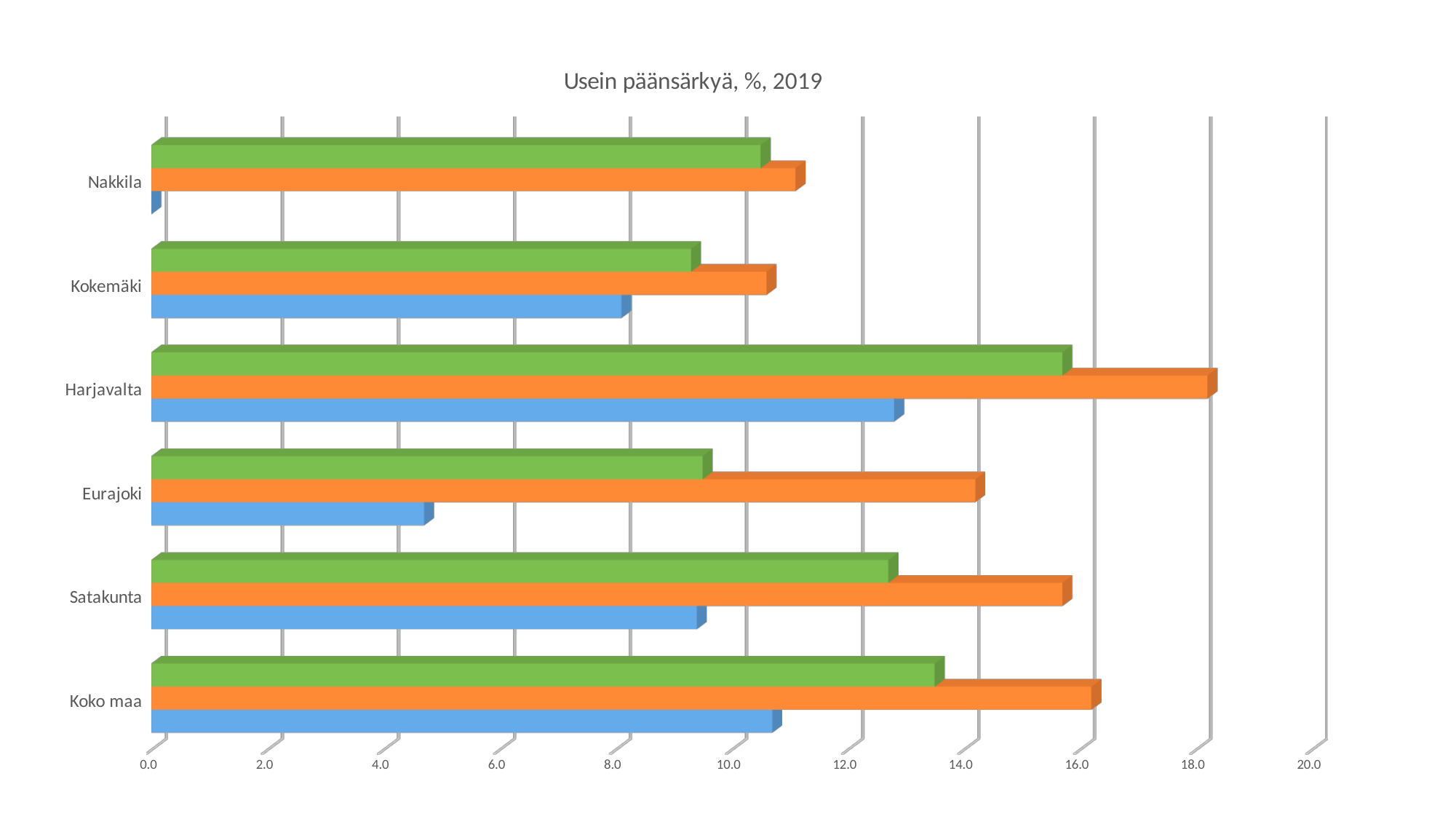
Is the blue bar for Eurajoki greater or less than 6.0? less Which has the larger blue bar: Harjavalta or Kokemäki? Harjavalta For Eurajoki, which is larger: the orange bar or the green bar? the orange bar Which category has the longest green bar? Harjavalta Is the green bar for Koko maa greater or less than 12.0? greater How many bars are plotted for each category in the chart? 3 Which category has the shortest blue bar? Nakkila How many categories are shown on the vertical axis of the chart? 6 What kind of chart is shown on the slide? bar chart Which category has the longest orange bar? Harjavalta What is the title of the chart? Usein päänsärkyä, %, 2019 Is the orange bar for Harjavalta greater or less than 16.0? greater